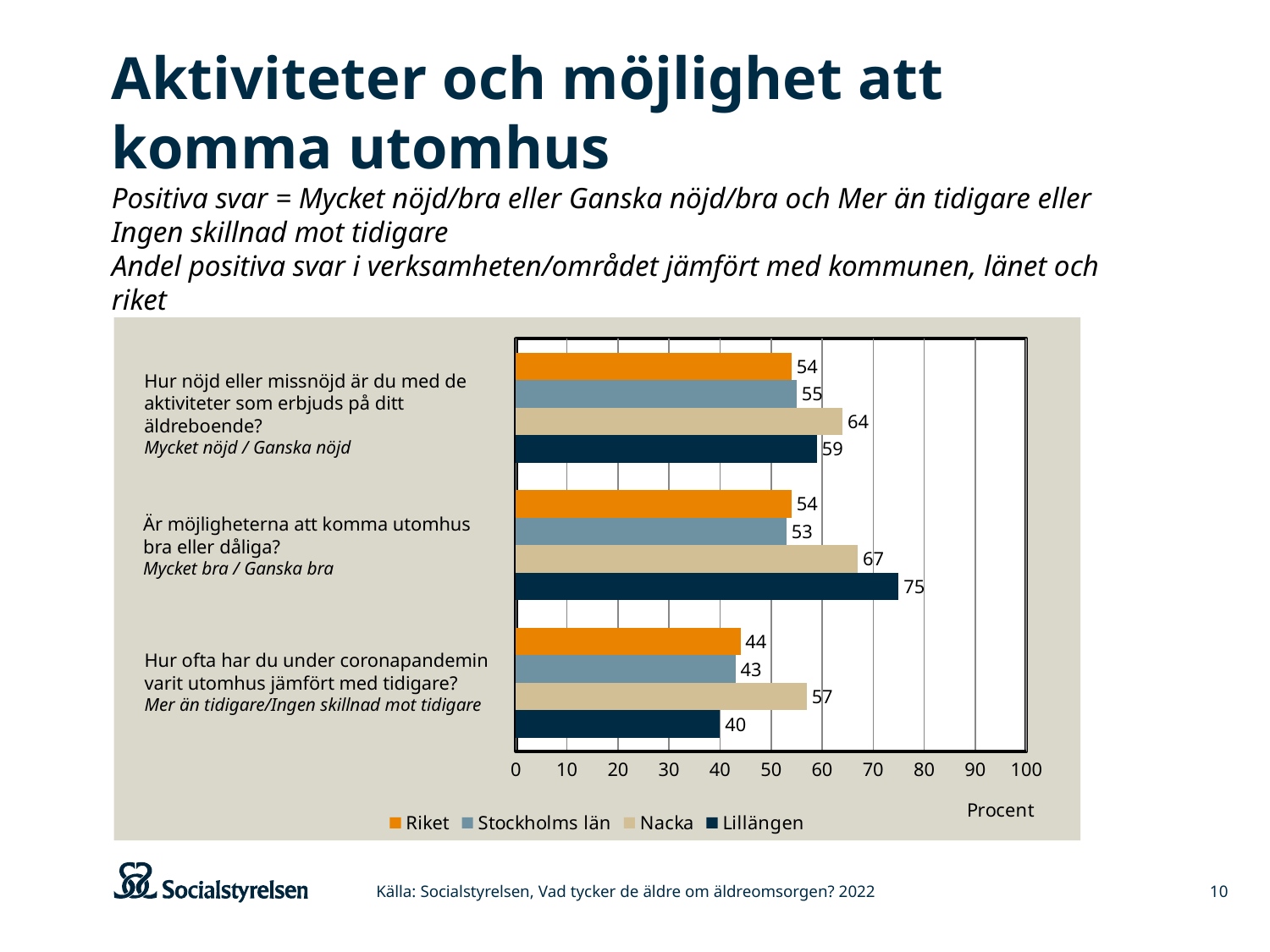
What is the value for Stockholms län on the question "Hur ofta har du under coronapandemin varit utomhus jämfört med tidigare?"? 43 What is the value for Nacka on the question "Hur nöjd eller missnöjd är du med de aktiviteter som erbjuds på ditt äldreboende?"? 64 What is the value for Lillängen on the question "Är möjligheterna att komma utomhus bra eller dåliga?"? 75 How many series does the legend list? 4 What is the difference between Lillängen and Riket on the question "Är möjligheterna att komma utomhus bra eller dåliga?"? 21 How many question categories are shown on the chart? 3 Which series has the highest value on the question "Hur ofta har du under coronapandemin varit utomhus jämfört med tidigare?"? Nacka Is the value for Lillängen on the question "Är möjligheterna att komma utomhus bra eller dåliga?" greater or less than 70? greater What unit is shown on the x axis of the chart? Procent Which series has the lowest value on the question "Hur ofta har du under coronapandemin varit utomhus jämfört med tidigare?"? Lillängen What kind of chart is shown on the slide? bar chart On the question "Hur nöjd eller missnöjd är du med de aktiviteter som erbjuds på ditt äldreboende?", which is larger: Nacka or Lillängen? Nacka